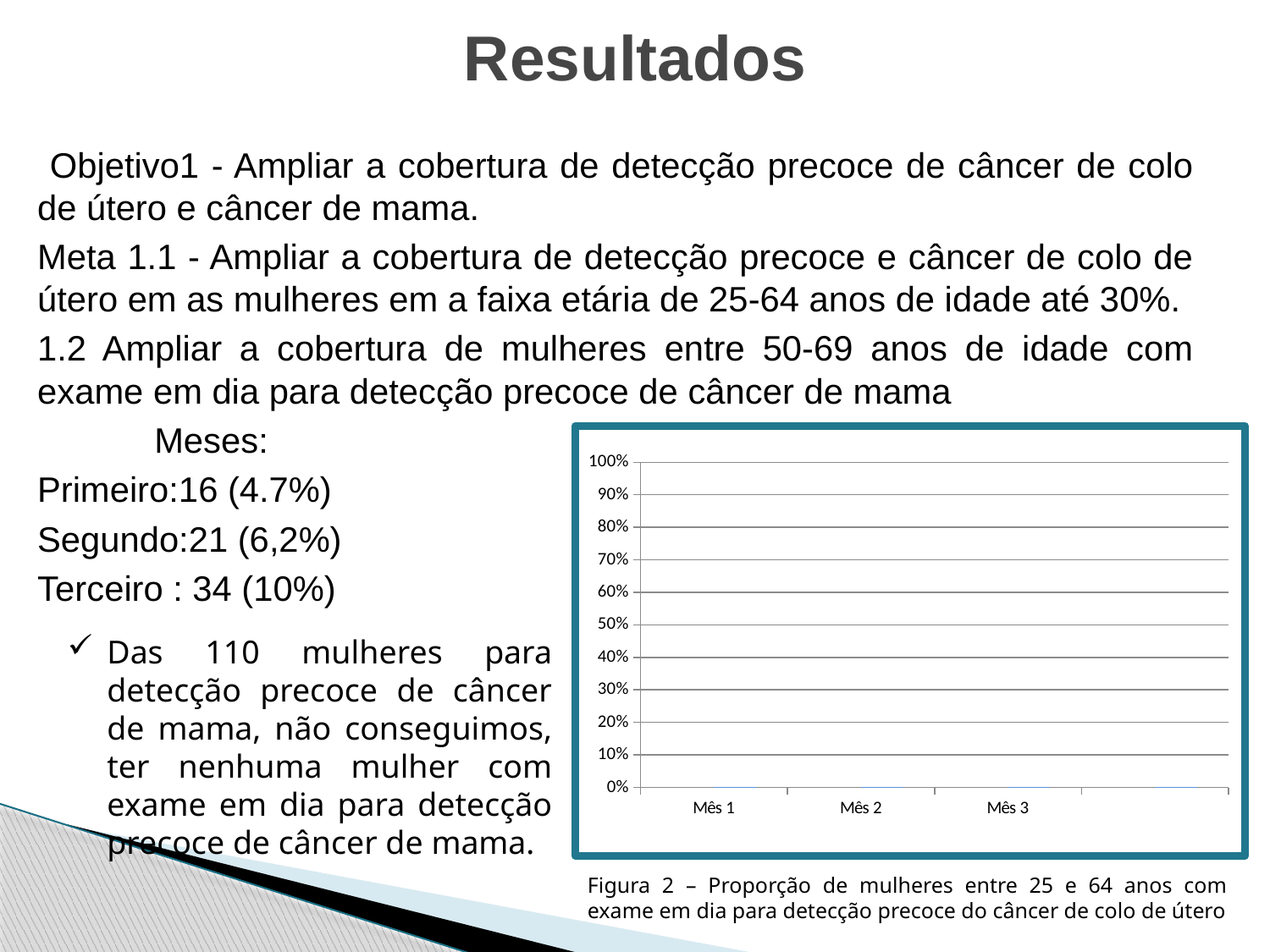
What is the label of the first category on the x axis of the chart? Mês 1 How many categories are shown on the x axis of the chart? 3 Is the value for Mês 2 greater or less than 20%? less Is the value for Mês 3 greater or less than 30%? less Is the value for Mês 1 greater or less than 20%? less What kind of chart is shown on the slide? bar chart What is the highest value shown on the y axis of the chart? 100%